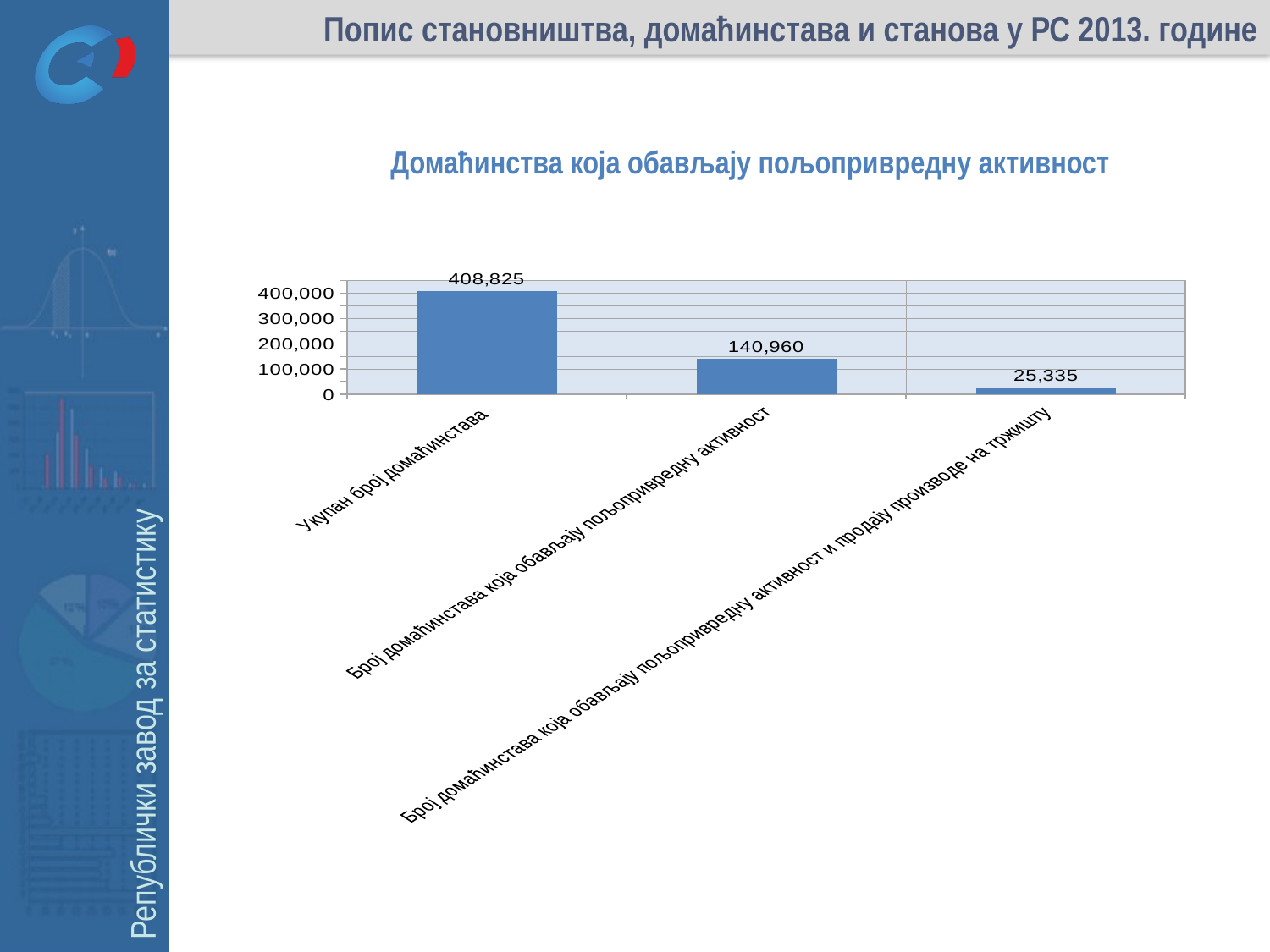
How many categories are shown in the chart? 3 What is the value for "Укупан број домаћинстава"? 408,825 What kind of chart is shown on the slide? bar chart What is the difference between the value for "Број домаћинстава која обављају пољопривредну активност" and the value for "Број домаћинстава која обављају пољопривредну активност и продају производе на тржишту"? 115,625 What is the value for "Број домаћинстава која обављају пољопривредну активност"? 140,960 What is the difference between the value for "Укупан број домаћинстава" and the value for "Број домаћинстава која обављају пољопривредну активност"? 267,865 Which category has the highest value? Укупан број домаћинстава Is the value for "Број домаћинстава која обављају пољопривредну активност" greater or less than 100,000? greater What is the title of the chart? Домаћинства која обављају пољопривредну активност Which category has the lowest value? Број домаћинстава која обављају пољопривредну активност и продају производе на тржишту What is the value for "Број домаћинстава која обављају пољопривредну активност и продају производе на тржишту"? 25,335 Which is larger: the value for "Број домаћинстава која обављају пољопривредну активност" or the value for "Број домаћинстава која обављају пољопривредну активност и продају производе на тржишту"? Број домаћинстава која обављају пољопривредну активност